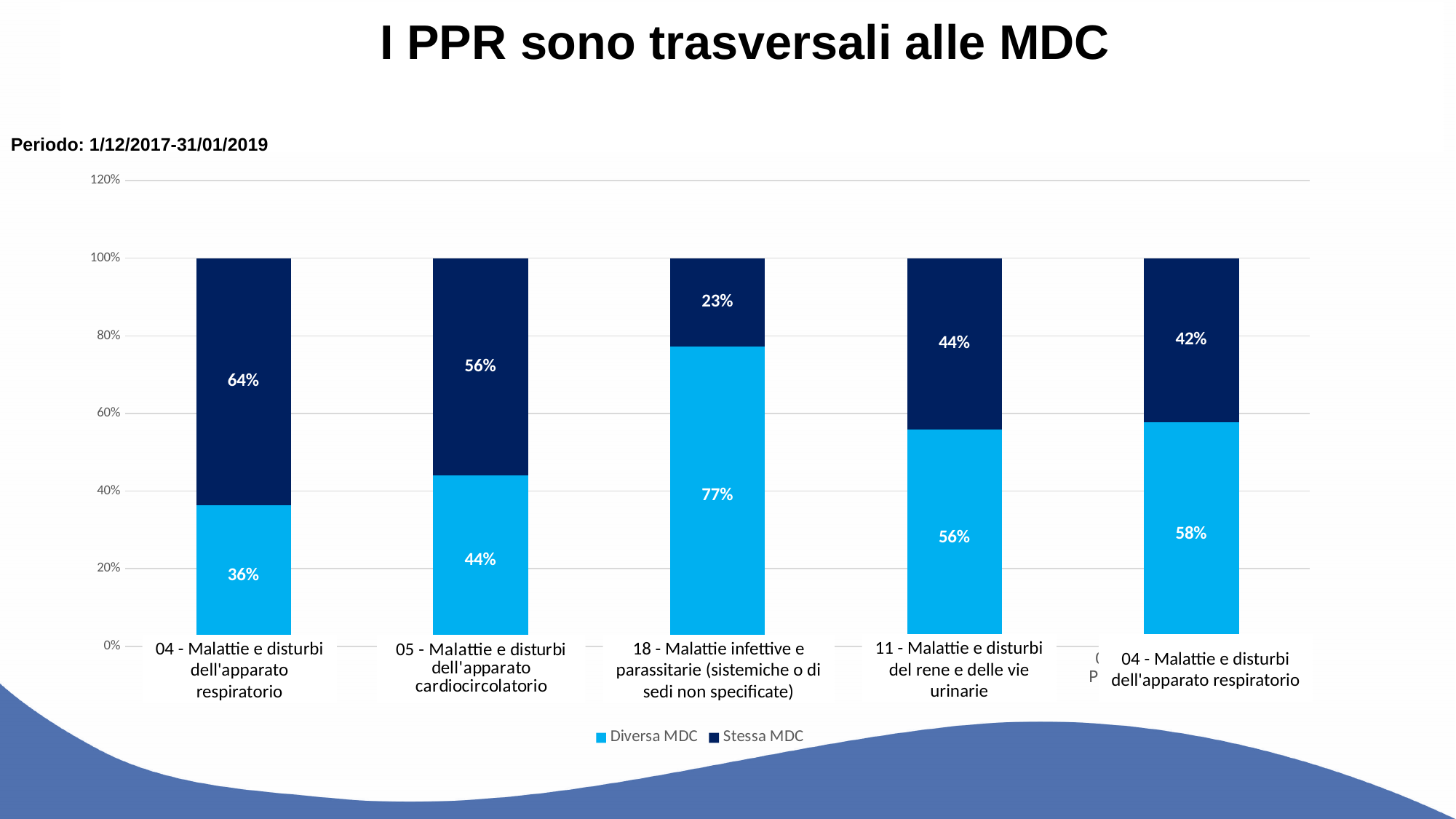
What kind of chart is shown on the slide? Stacked bar chart Which has the larger Diversa MDC share: '11 - Malattie e disturbi del rene e delle vie urinarie' or '05 - Malattie e disturbi dell'apparato cardiocircolatorio'? 11 - Malattie e disturbi del rene e delle vie urinarie What are the two series named in the legend? Diversa MDC and Stessa MDC Which category has the lowest Stessa MDC share? 18 - Malattie infettive e parassitarie (sistemiche o di sedi non specificate) How many series does the legend list? 2 What is the Stessa MDC value for '11 - Malattie e disturbi del rene e delle vie urinarie'? 44% How many bars are plotted in the chart? 5 What is the Stessa MDC value for '18 - Malattie infettive e parassitarie (sistemiche o di sedi non specificate)'? 23% For the first bar, '04 - Malattie e disturbi dell'apparato respiratorio', how many percentage points larger is Stessa MDC than Diversa MDC? 28 percentage points What is the Diversa MDC value for '05 - Malattie e disturbi dell'apparato cardiocircolatorio'? 44% What is the Diversa MDC value shown in the rightmost bar of the chart? 58% Which category has the highest Diversa MDC share? 18 - Malattie infettive e parassitarie (sistemiche o di sedi non specificate)